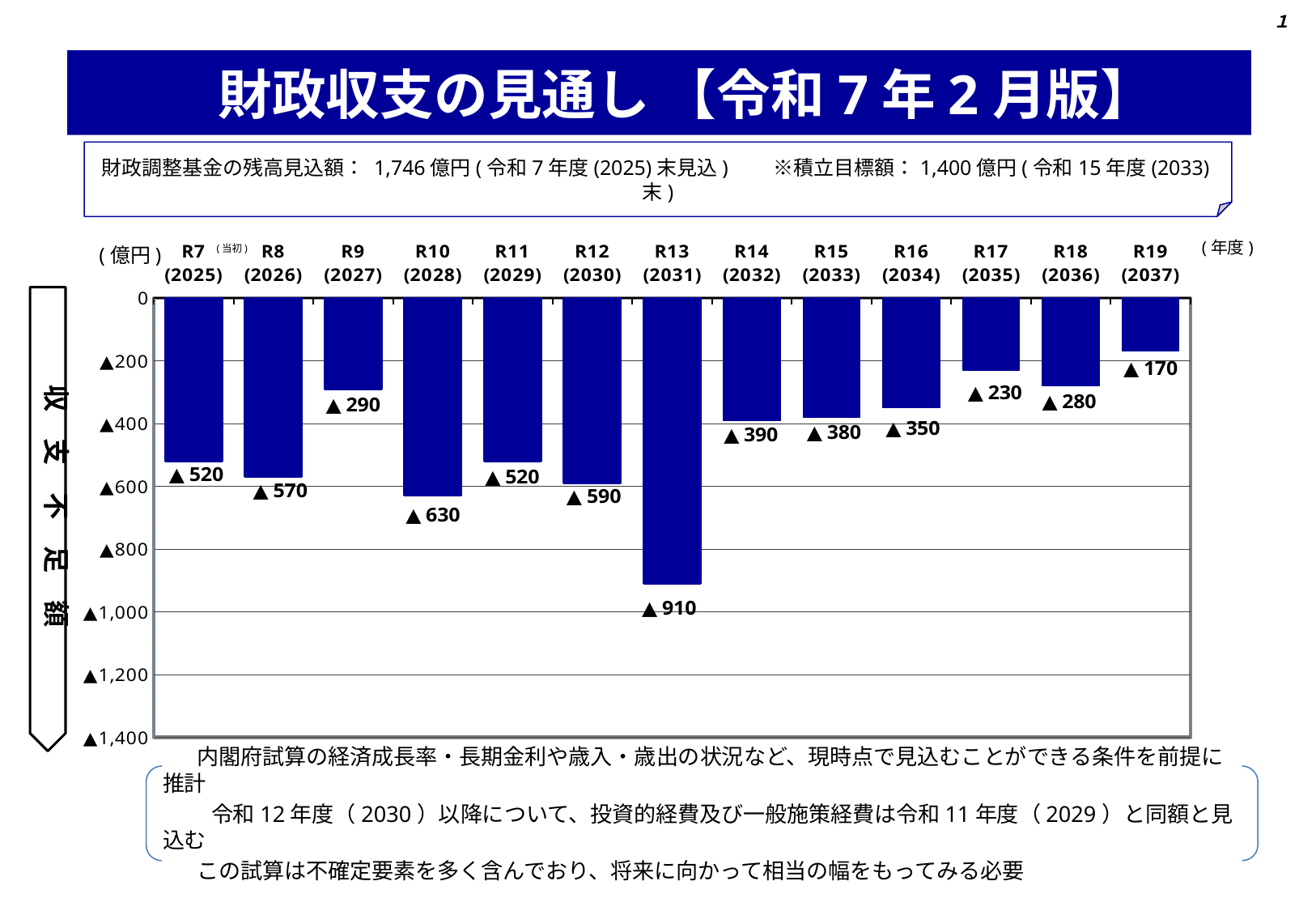
How many fiscal years are plotted in the chart? 13 By how much does the shortfall for R13 (2031) exceed that for R7 (2025)? 390 Which has the larger shortfall, R12 (2030) or R16 (2034)? R12 (2030) What is the value shown for R19 (2037)? ▲170 What is the value shown for R7 (2025)? ▲520 What is the value shown for R16 (2034)? ▲350 Which fiscal year has the largest shortfall (longest bar)? R13 (2031) What is the value shown for R13 (2031)? ▲910 From R13 (2031) to R19 (2037), does the shortfall rise or fall each year? Neither consistently — it falls each year except from R17 (2035) to R18 (2036), when it rises from ▲230 to ▲280 What kind of chart is shown on the slide? Bar chart By how much does the shortfall for R10 (2028) exceed that for R9 (2027)? 340 Which fiscal year has the smallest shortfall (shortest bar)? R19 (2037)